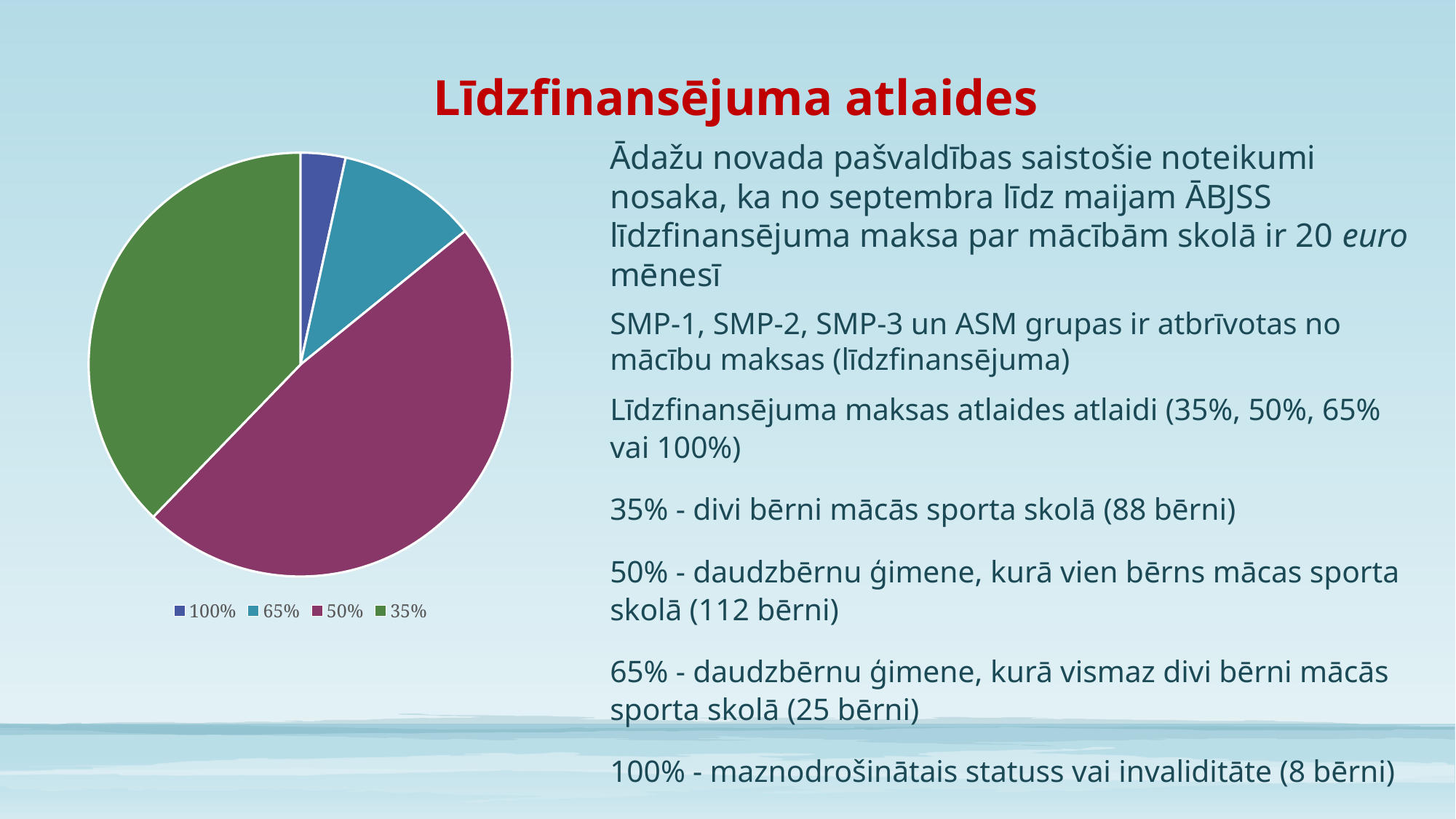
Which category has the second largest slice in the pie chart? 35% Which slice is larger in the pie chart, 50% or 35%? 50% How many entries does the legend of the pie chart list? 4 What kind of chart is shown on the slide? pie chart Which category has the largest slice in the pie chart? 50% Which slice is larger in the pie chart, 35% or 65%? 35% Which category has the smallest slice in the pie chart? 100% How many slices does the pie chart have? 4 Which slice is larger in the pie chart, 65% or 100%? 65% What is the title of the slide containing the pie chart? Līdzfinansējuma atlaides What colour is the 35% slice in the pie chart? green